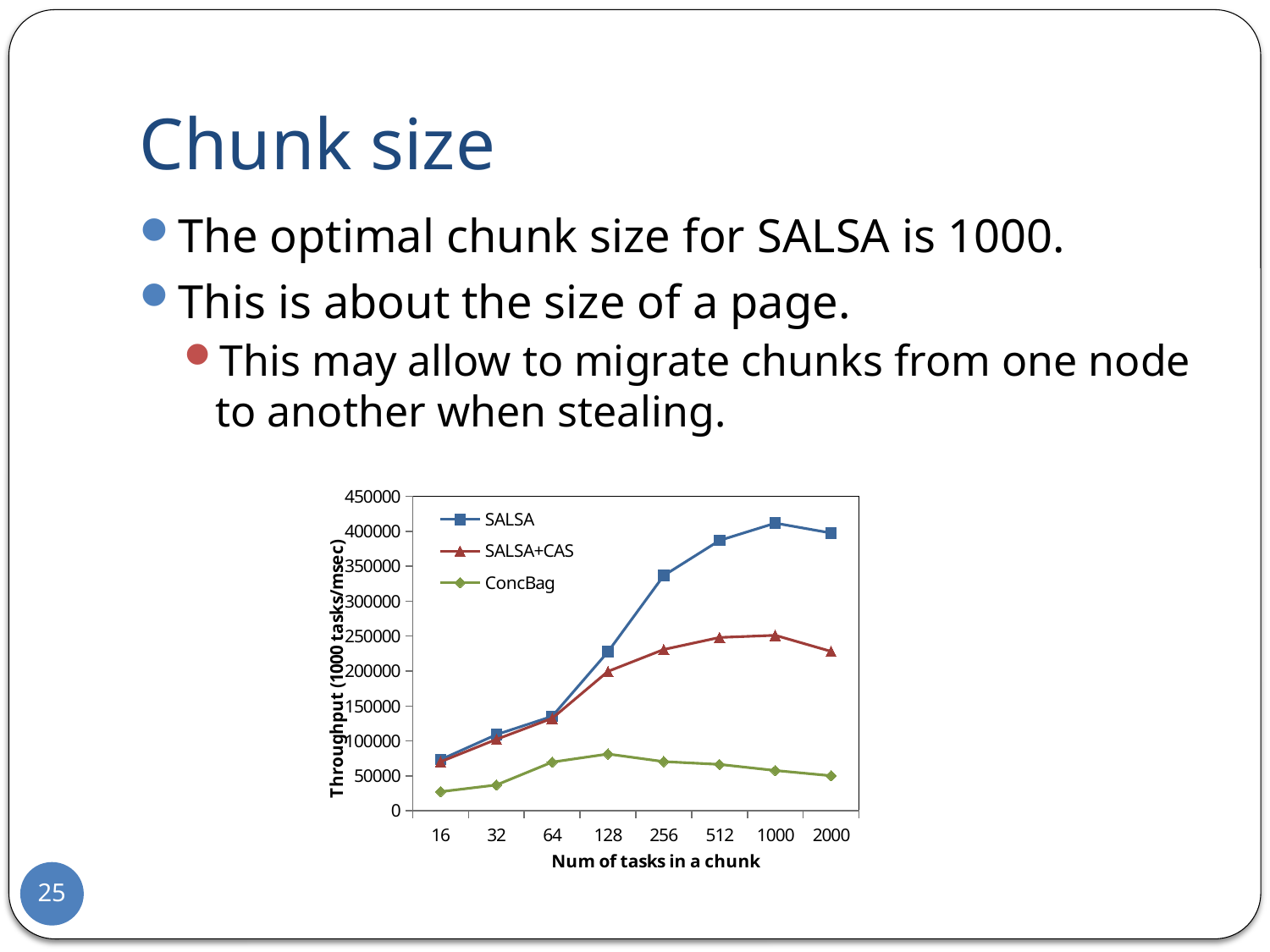
Does the ConcBag throughput rise or fall from chunk size 128 to chunk size 2000? fall How many chunk sizes are plotted along the x axis? 8 Is the SALSA+CAS throughput at chunk size 1000 greater or less than 300000? less What kind of chart is shown on the slide? line chart Is the SALSA throughput at chunk size 16 greater or less than 100000? less Which series has the lowest throughput at chunk size 16? ConcBag What is the label of the y axis of the chart? Throughput (1000 tasks/msec) At chunk size 2000, which series has the higher throughput, SALSA or SALSA+CAS? SALSA How many series does the chart legend list? 3 At which number of tasks in a chunk does SALSA reach its highest throughput? 1000 Is the SALSA throughput at chunk size 1000 greater or less than 400000? greater